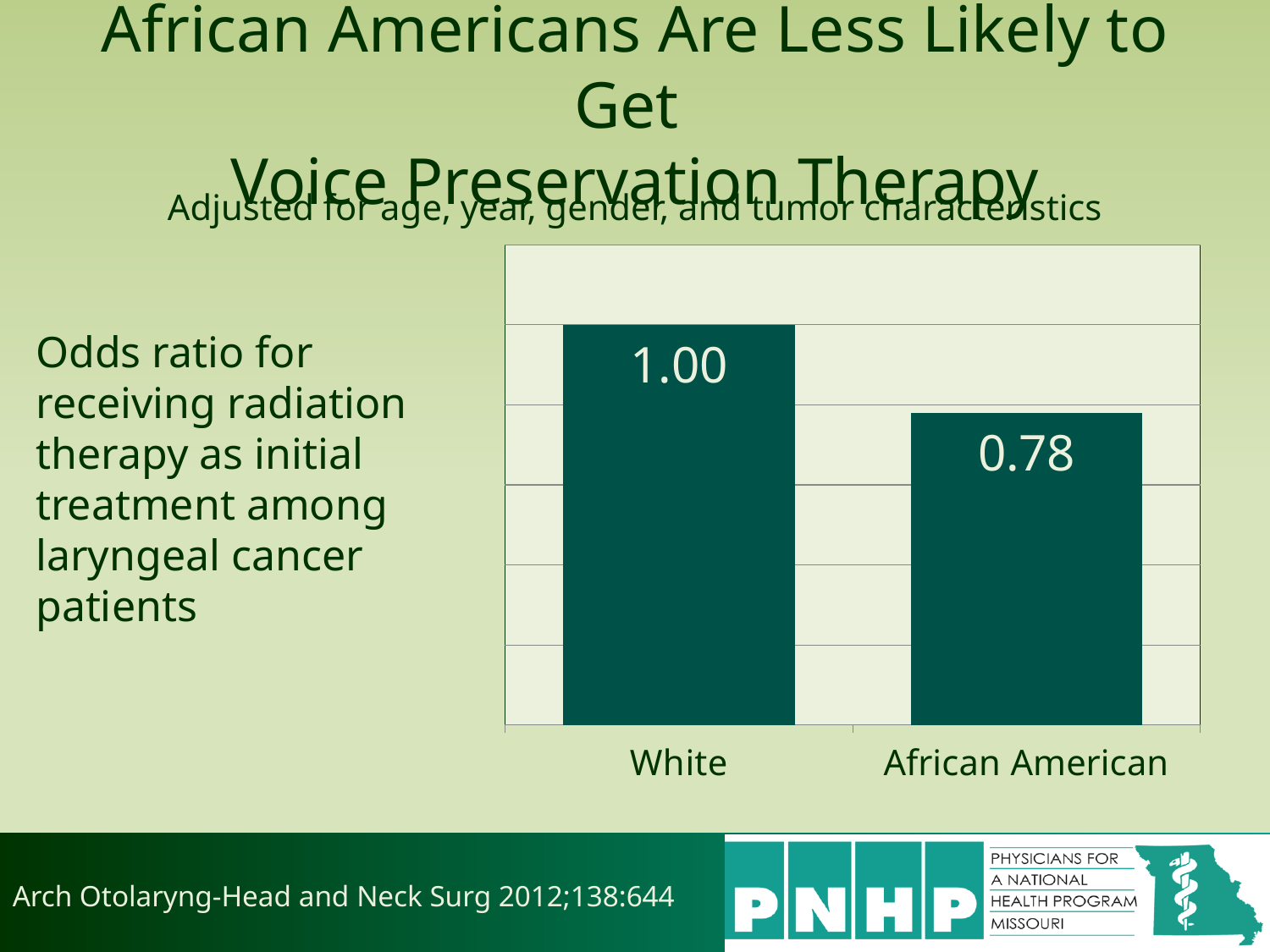
What kind of chart is shown on the slide? bar chart Which category has the lower odds ratio? African American What is the odds ratio shown for African American patients? 0.78 How many categories are shown on the x axis of the chart? 2 Is the value for White patients larger or smaller than the value for African American patients? larger Do the values rise or fall from left to right across the x axis? fall What colour are the bars in the chart? dark green What is the odds ratio shown for White patients? 1.00 What are the two category labels on the x axis of the chart? White, African American What is the difference between the odds ratio for White patients and for African American patients? 0.22 Which category has the higher odds ratio? White